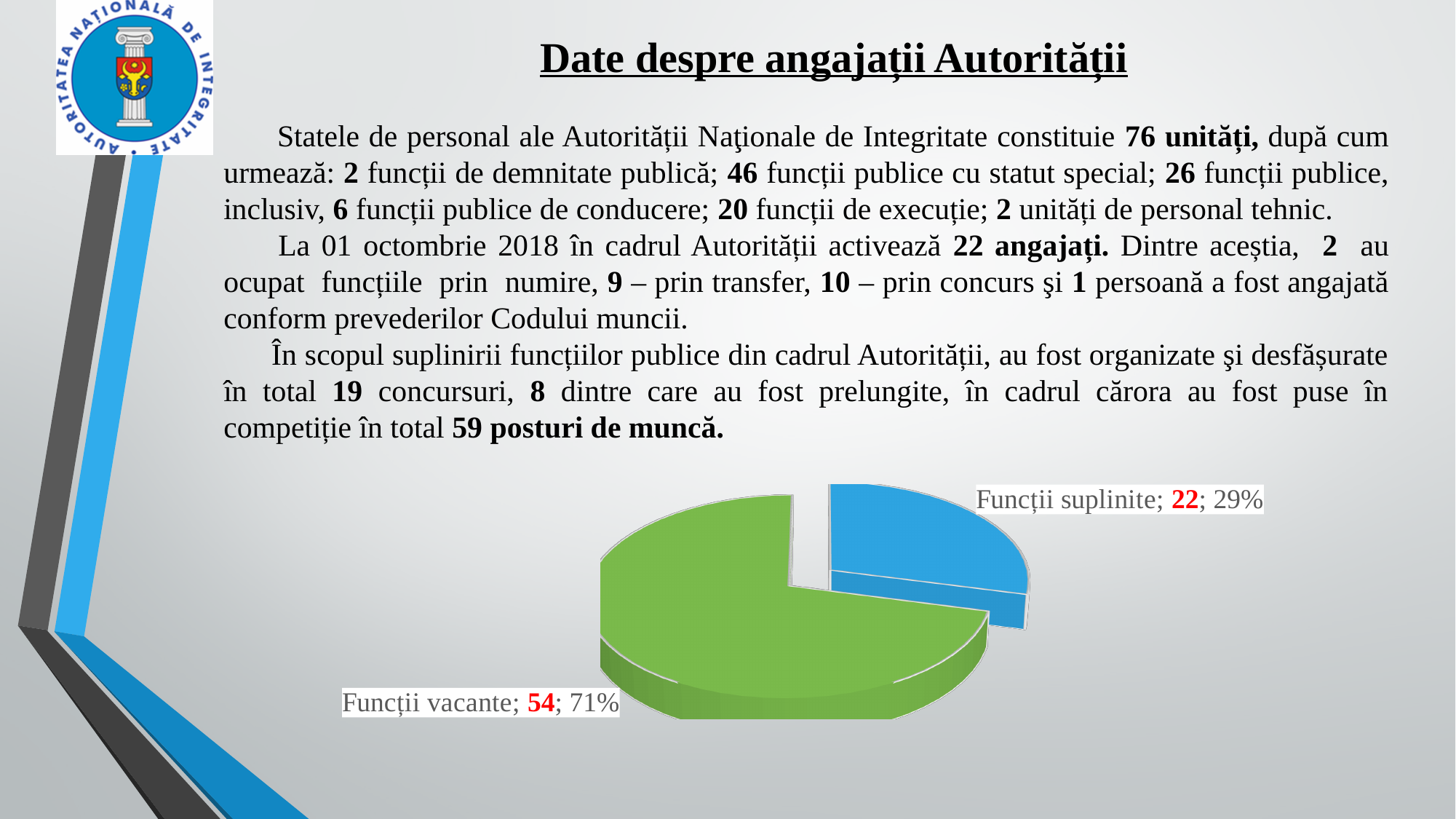
What kind of chart is shown on the slide? pie chart What share of the pie does Funcții vacante represent? 71% What is the value for Funcții vacante? 54 Which slice is the smallest? Funcții suplinite Which slice is the largest? Funcții vacante What is the difference between the values for Funcții vacante and Funcții suplinite? 32 What is the total of the two slices in the pie chart? 76 What colour is the Funcții suplinite slice? blue What is the value for Funcții suplinite? 22 How many slices does the pie chart have? 2 What share of the pie does Funcții suplinite represent? 29% Which is larger, Funcții vacante or Funcții suplinite? Funcții vacante